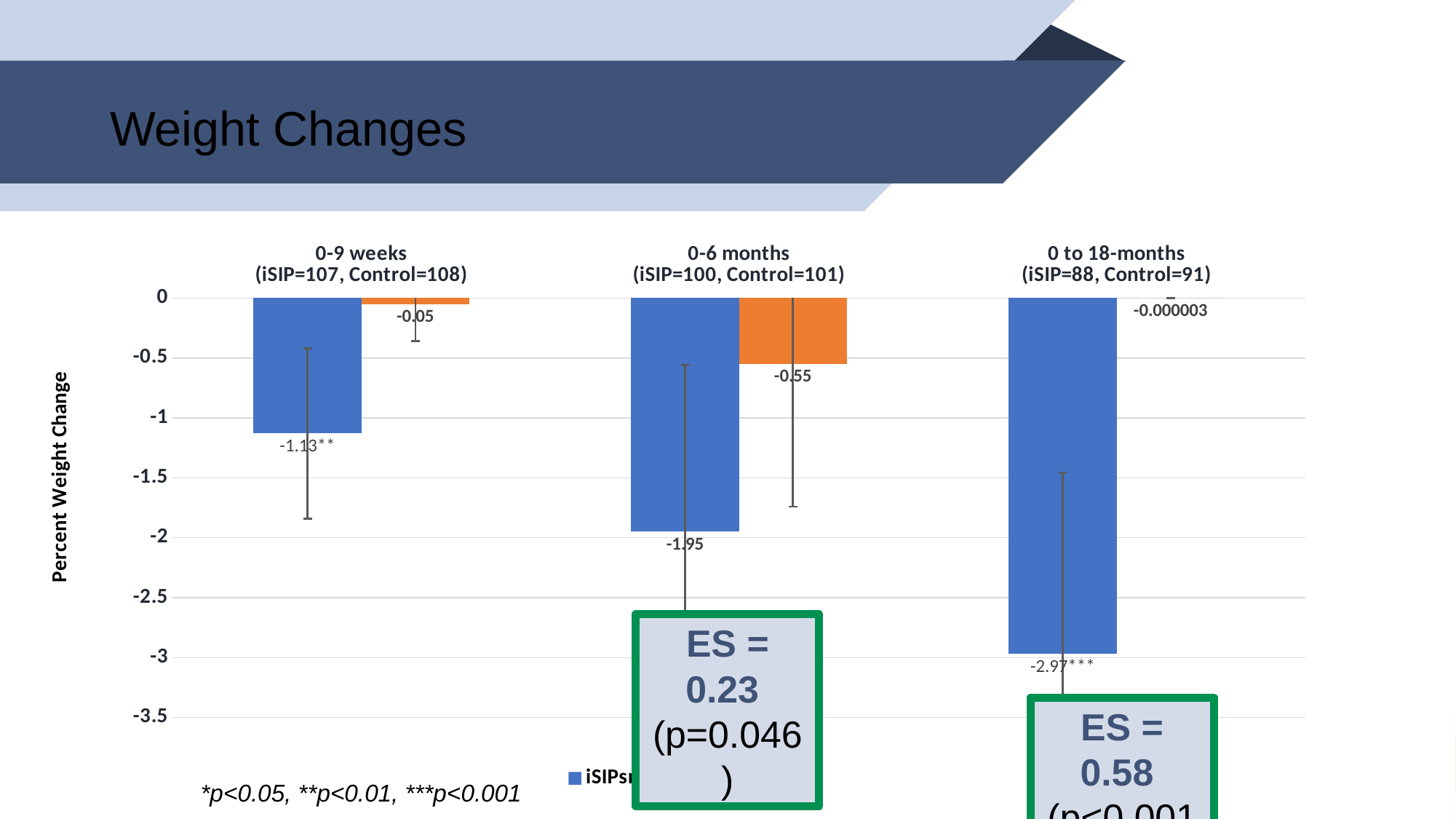
In the 0-6 months period, which bar shows the larger weight decrease, the blue bar or the orange bar? blue bar What type of chart is shown on the slide? bar chart What is the value of the blue bar for the 0-6 months period? -1.95 What is the title of the y axis? Percent Weight Change What is the difference between the blue bar (-1.95) and the orange bar (-0.55) in the 0-6 months period? 1.4 What is the value of the orange bar for the 0 to 18-months period? -0.000003 What is the value of the orange bar for the 0-9 weeks period? -0.05 What is the value of the orange bar for the 0-6 months period? -0.55 How many time periods are shown on the x axis? 3 What data label is shown on the blue bar for the 0 to 18-months period? -2.97*** Which time period has the lowest (most negative) blue bar value? 0 to 18-months From left to right across the time periods, do the blue bar values become more negative or less negative? more negative